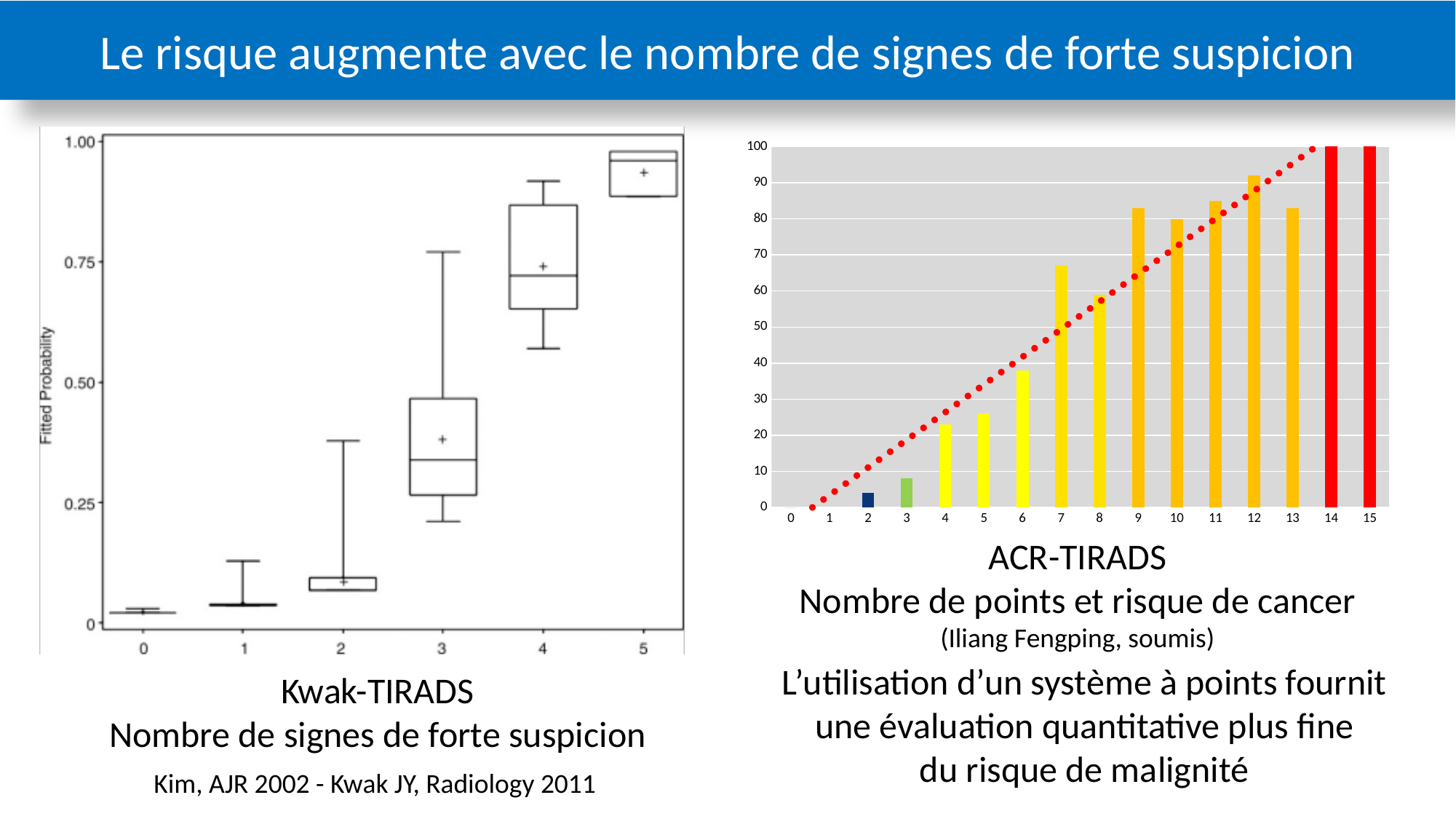
In the ACR-TIRADS chart, is the value for 3 greater or less than 10? less In the ACR-TIRADS chart, is the value for 9 greater or less than 70? greater In the ACR-TIRADS chart, is the value for 6 greater or less than 30? greater In the ACR-TIRADS chart, what colour are the bars for 14 and 15? red In the Kwak-TIRADS chart, how many categories are shown on the x axis? 6 In the ACR-TIRADS chart, do the values generally rise or fall as the number of points increases along the x axis? rise What kind of chart is the left-hand chart (Kwak-TIRADS)? box plot In the ACR-TIRADS chart, how many categories are shown on the x axis? 16 What kind of chart is the right-hand chart (ACR-TIRADS)? bar chart In the ACR-TIRADS chart, which is larger, the value for 7 or the value for 8? 7